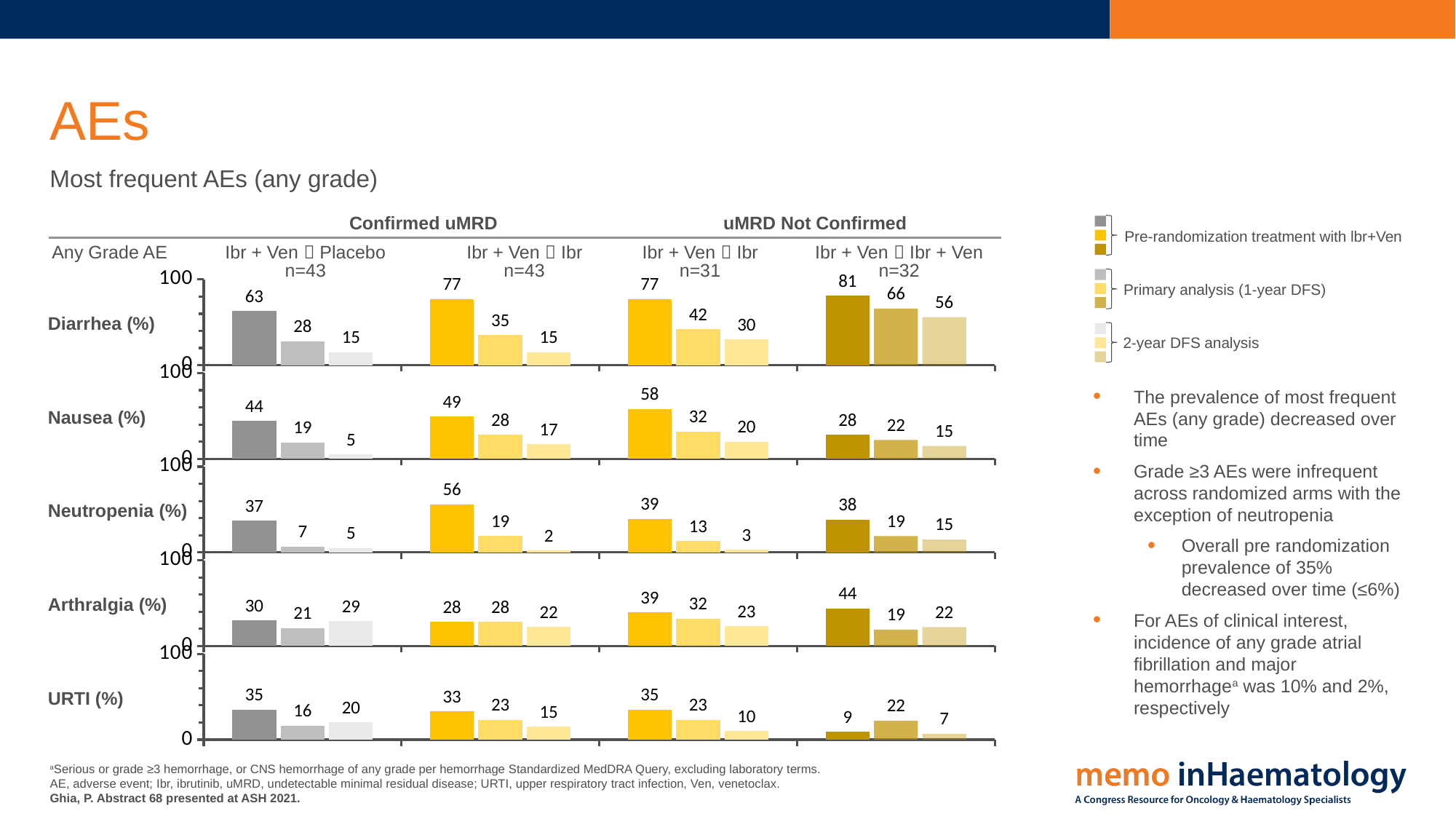
In the Neutropenia (%) chart, what is the 2-year DFS analysis value for the Confirmed uMRD Ibr + Ven → Ibr (n=43) arm? 2 What kind of chart is used to show the AE frequencies on this slide? Bar chart In the Arthralgia (%) chart, which is larger at the primary analysis (1-year DFS): the Ibr + Ven → Placebo (n=43) arm or the uMRD Not Confirmed Ibr + Ven → Ibr (n=31) arm? Ibr + Ven → Ibr (n=31) In the Diarrhea (%) chart, what is the difference between the pre-randomization value and the 2-year DFS analysis value for the Ibr + Ven → Placebo (n=43) arm? 48 In the URTI (%) chart, which arm has the lowest pre-randomization value? Ibr + Ven → Ibr + Ven (n=32) In the Nausea (%) chart, do the values for the uMRD Not Confirmed Ibr + Ven → Ibr (n=31) arm rise or fall from pre-randomization to the 2-year DFS analysis? Fall In the Nausea (%) chart, what is the 2-year DFS analysis value for the Ibr + Ven → Placebo (n=43) arm? 5 What is the maximum value shown on the y-axis of each AE chart? 100 How many adverse event charts (rows) are shown on the slide? 5 In the Neutropenia (%) chart, which arm has the highest pre-randomization value? Ibr + Ven → Ibr (n=43, Confirmed uMRD) How many series does the legend list? 3 In the Diarrhea (%) chart, what is the pre-randomization value for the Ibr + Ven → Ibr + Ven (n=32) arm? 81